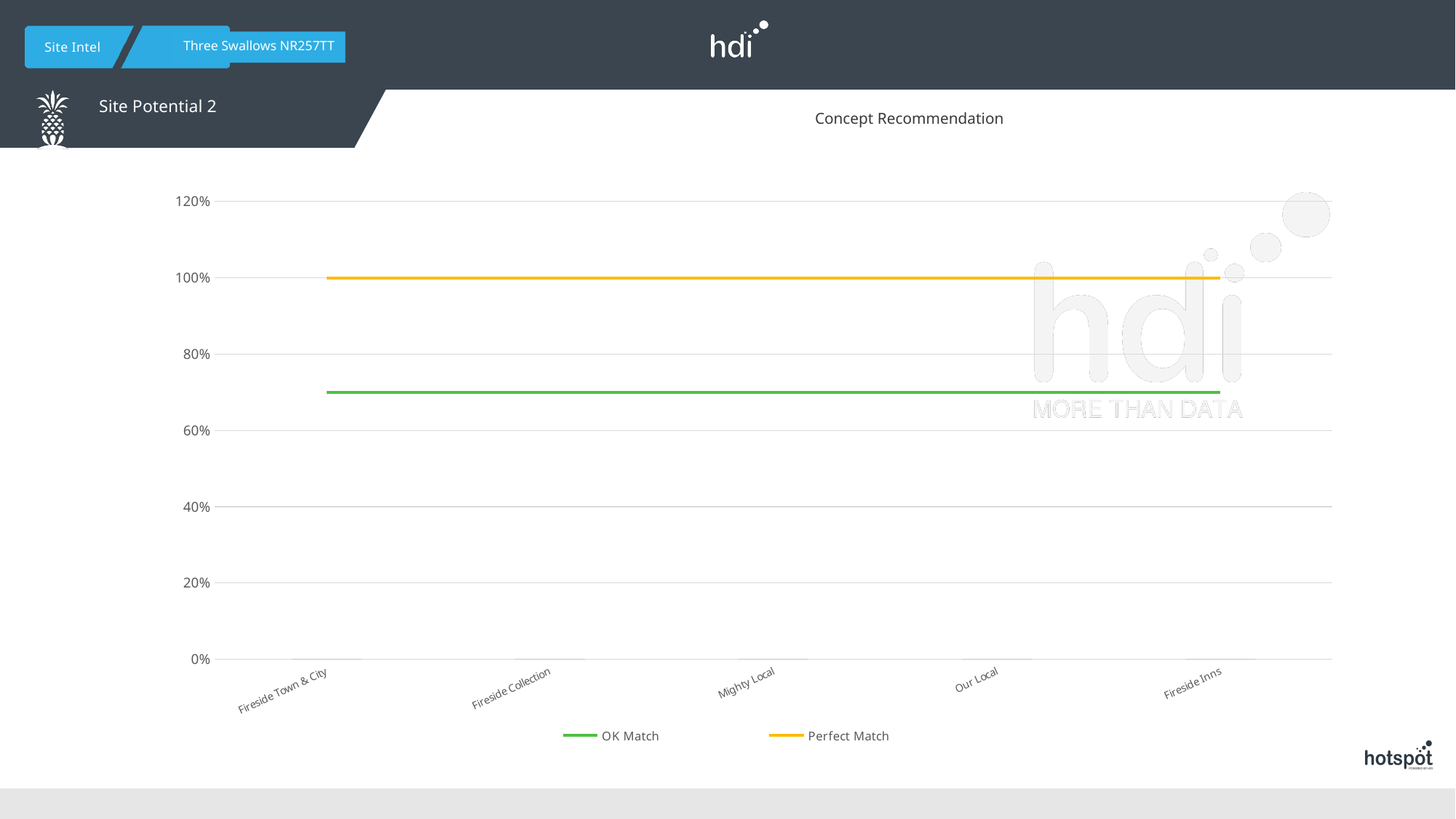
Is the OK Match value for Our Local greater or less than 60%? greater Which colour is used for the Perfect Match line? yellow Does the OK Match line rise, fall or stay flat across the categories? stays flat What is the title of the chart? Concept Recommendation Which series is higher, OK Match or Perfect Match? Perfect Match Is the Perfect Match value for Fireside Town & City greater or less than 80%? greater How many categories are shown on the x axis? 5 How many series does the legend list? 2 What value does the Perfect Match line sit at for Mighty Local? 100% Is the OK Match value for Fireside Collection greater or less than 80%? less What value does the Perfect Match line sit at for Fireside Inns? 100% What kind of chart is shown on the slide? line chart